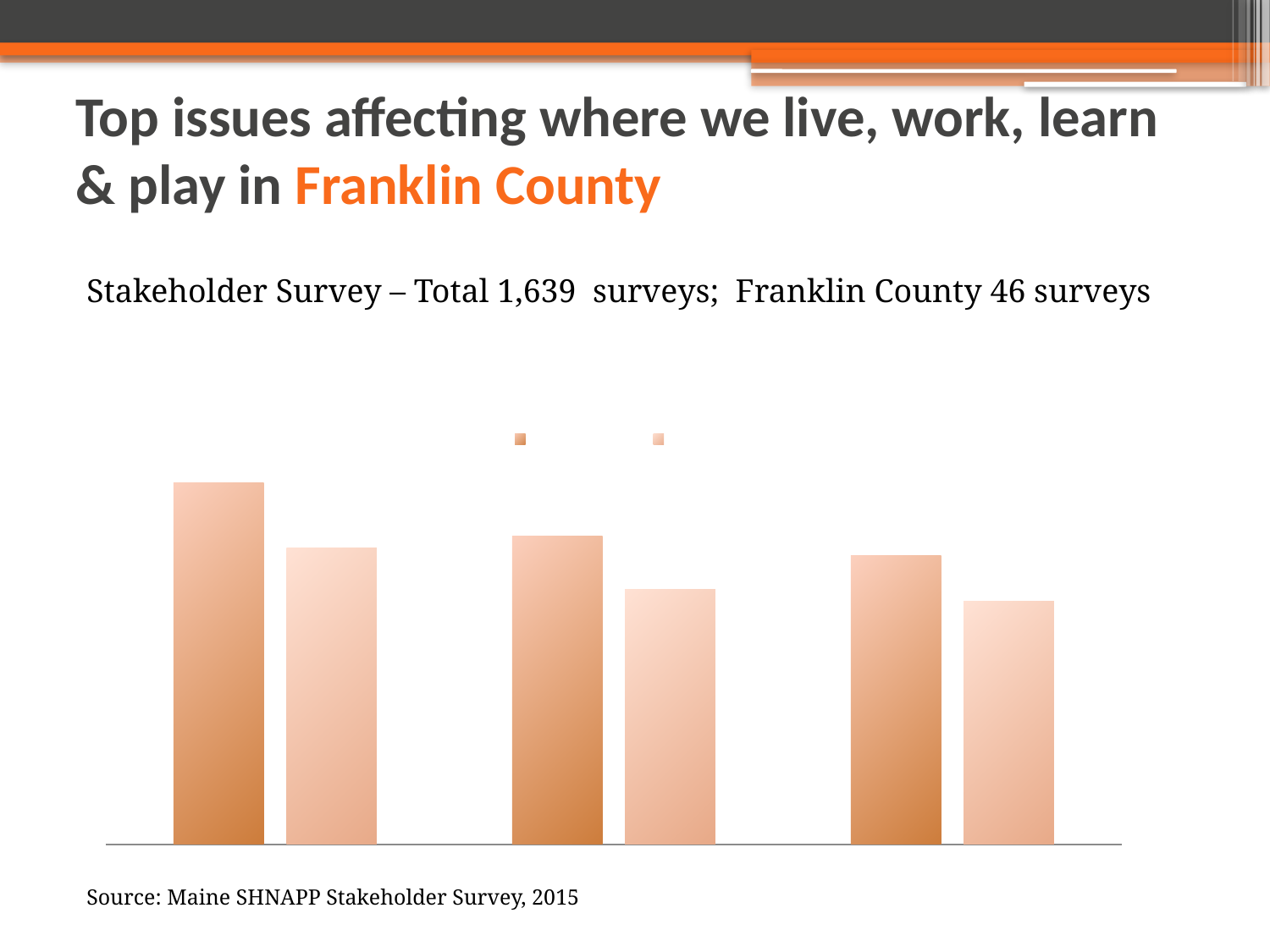
How many groups of bars (categories) are plotted in the chart? 3 Do the darker bars rise or fall from left to right across the chart? fall What kind of chart is shown on the slide? bar chart Which is taller: the darker bar in the middle group or the lighter bar in the leftmost group? the darker bar in the middle group In the rightmost group, which bar is taller: the darker bar or the lighter bar? the darker bar Which group of bars has the tallest bar in the chart: the leftmost, middle, or rightmost? leftmost Which group of bars has the shortest bar in the chart: the leftmost, middle, or rightmost? rightmost Are the bars in the chart vertical or horizontal? vertical Does the chart display data labels with values on the bars? No How many series does the chart's legend list? 2 In the leftmost group, which bar is taller: the darker bar or the lighter bar? the darker bar Do the lighter bars rise or fall from left to right across the chart? fall